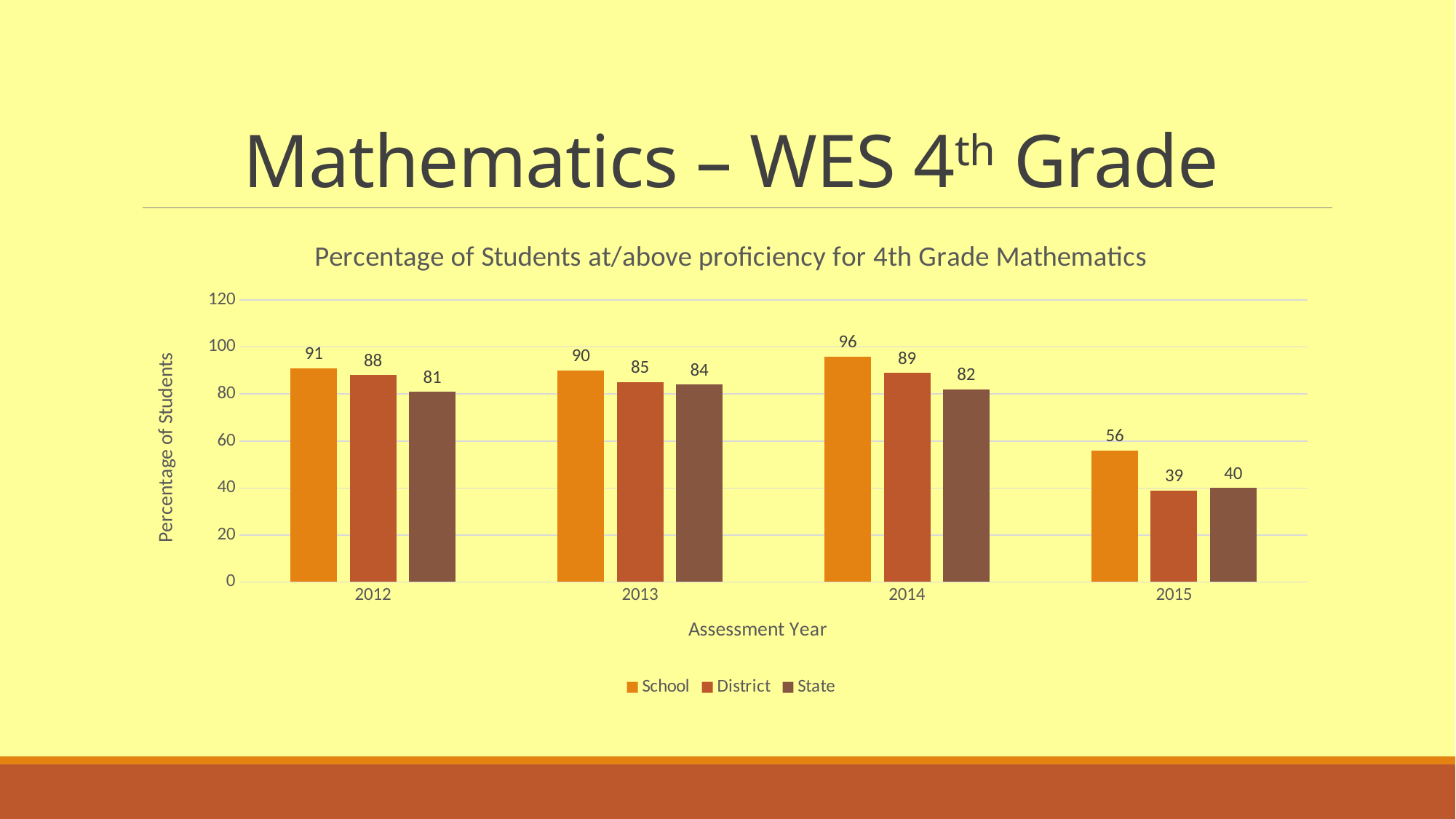
In which year is the School value highest? 2014 How many series does the legend list? 3 Which is larger in 2013, the District value or the State value? District What is the District value for 2015? 39 What is the title of the chart? Percentage of Students at/above proficiency for 4th Grade Mathematics How many assessment years are shown on the x axis? 4 What is the School value for 2014? 96 In which year is the State value lowest? 2015 What is the State value for 2012? 81 What is the difference between the School and District values in 2015? 17 Is the School value for 2015 greater or less than 60? less What kind of chart is shown on the slide? bar chart